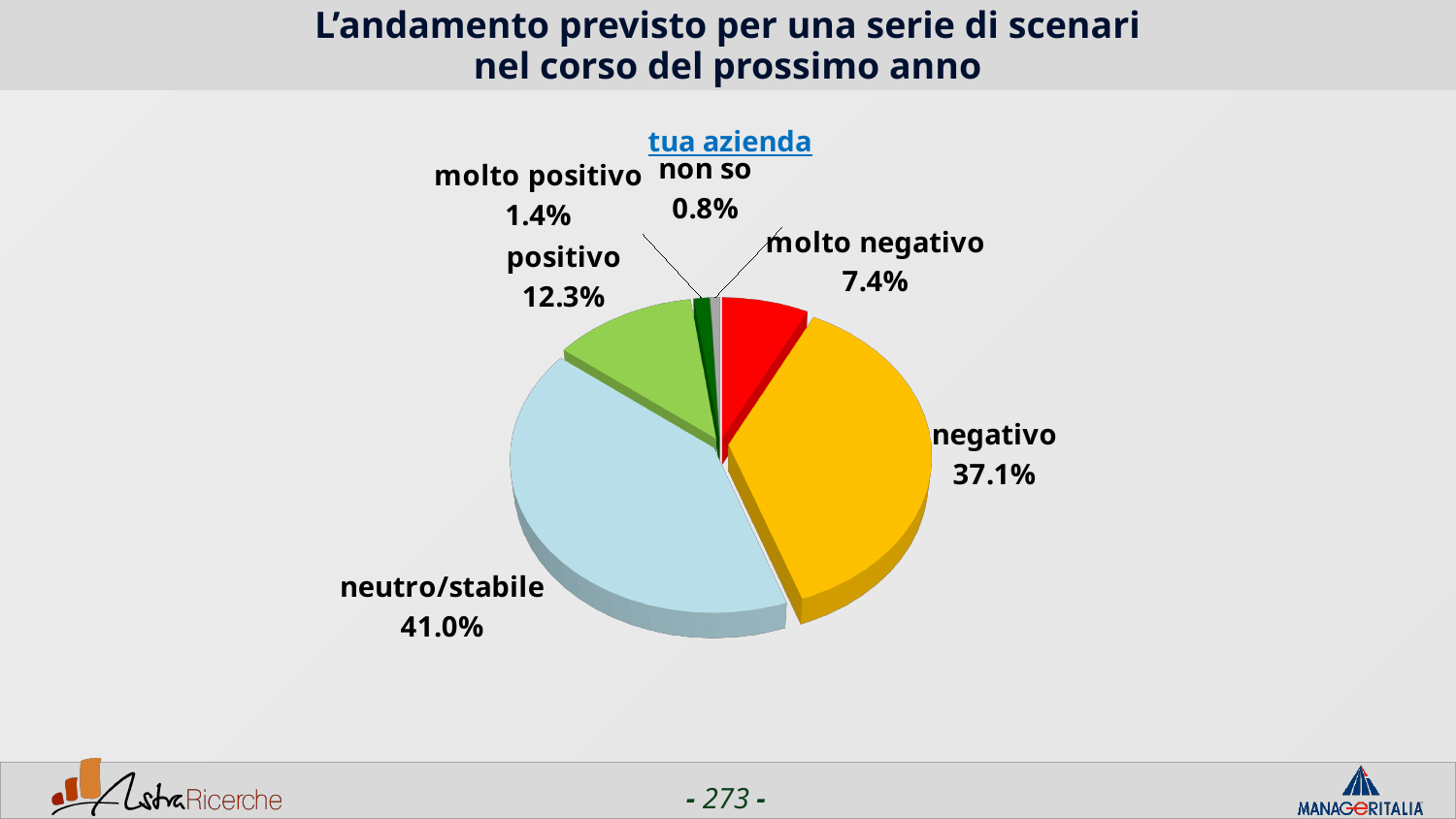
What is the value for "neutro/stabile"? 41.0% What is the value for "negativo"? 37.1% What is the difference between the values for "neutro/stabile" and "negativo"? 3.9% What is the value for "molto negativo"? 7.4% What kind of chart is shown on the slide? pie chart What is the title shown above the pie chart? tua azienda What is the value for "positivo"? 12.3% How many categories does the pie chart have? 6 Which is larger, the value for "positivo" or the value for "molto negativo"? positivo What is the value for "non so"? 0.8% Which category has the smallest slice? non so Which category has the largest slice? neutro/stabile